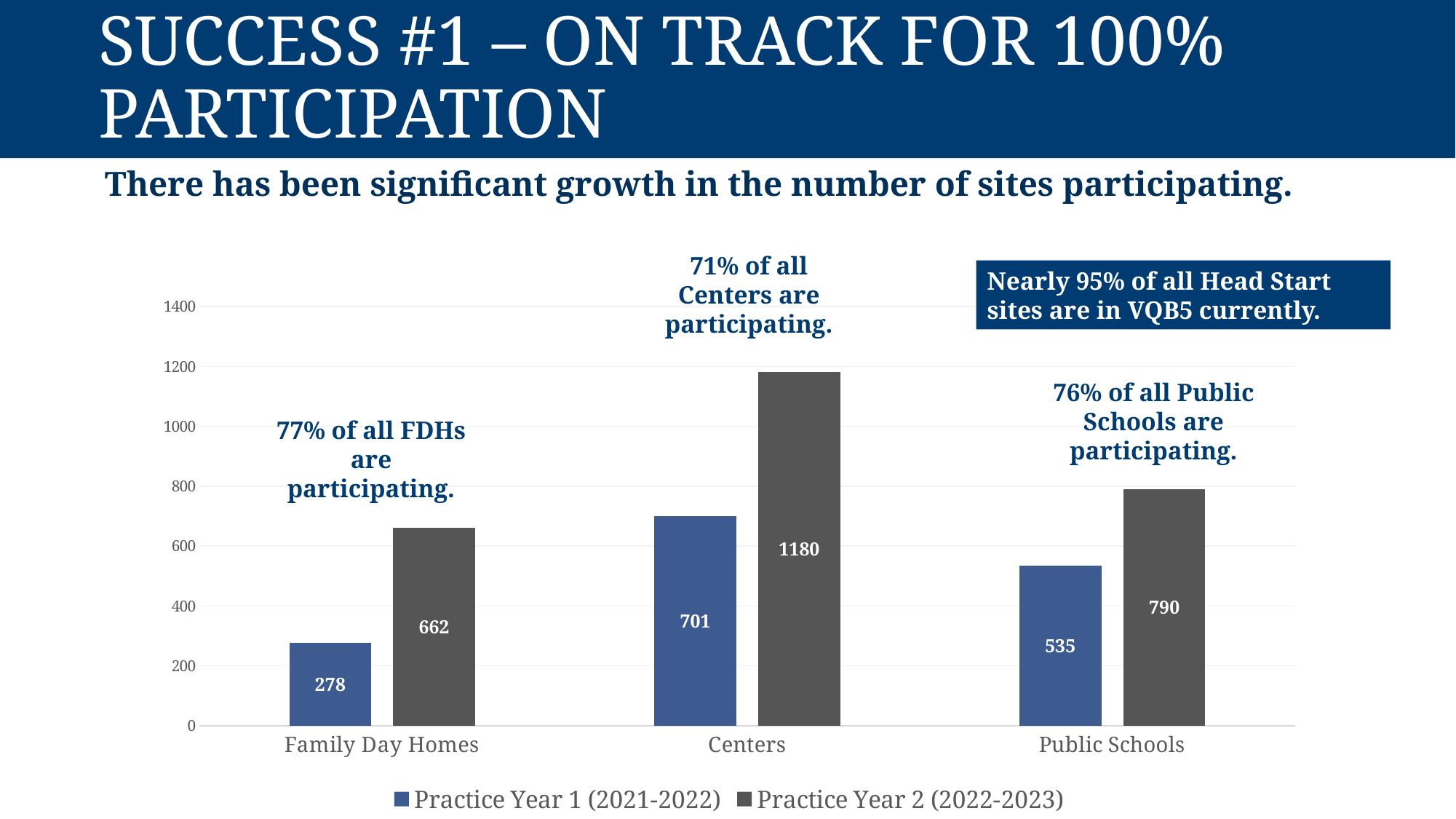
How many series does the legend list? 2 What is the difference between the Practice Year 2 and Practice Year 1 values for Family Day Homes? 384 Which category has the highest value in Practice Year 2 (2022-2023)? Centers Is the Practice Year 2 (2022-2023) value for Centers greater or less than 1000? greater Which is larger: the Practice Year 1 value for Centers or the Practice Year 2 value for Family Day Homes? Practice Year 1 value for Centers Which category has the lowest value in Practice Year 1 (2021-2022)? Family Day Homes How many categories are shown on the x axis? 3 What is the value for Public Schools in Practice Year 1 (2021-2022)? 535 What kind of chart is shown on the slide? Bar chart What is the value for Centers in Practice Year 2 (2022-2023)? 1180 What is the difference between the Practice Year 2 and Practice Year 1 values for Public Schools? 255 What is the value for Family Day Homes in Practice Year 1 (2021-2022)? 278